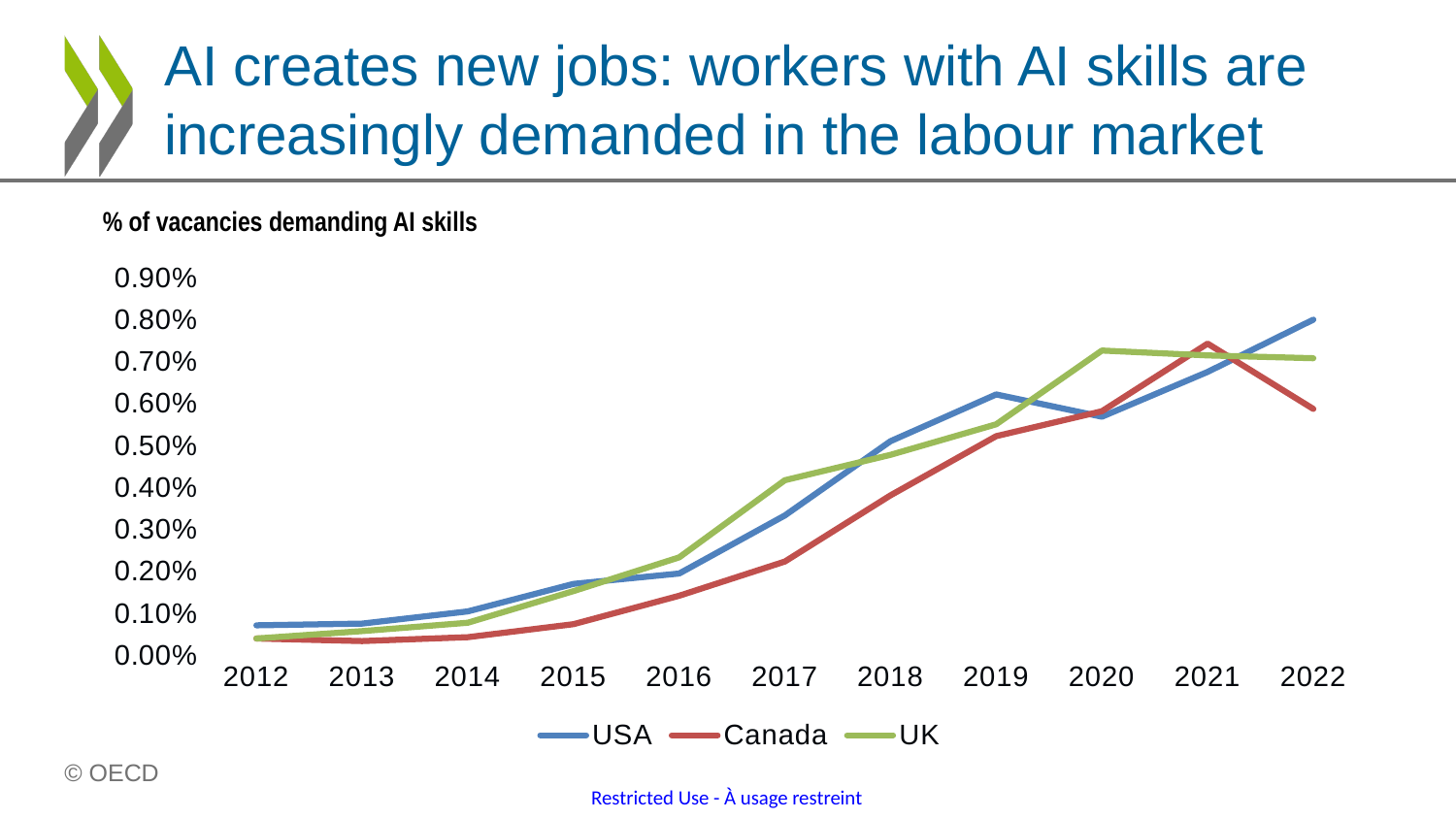
Is the value for USA in 2022 greater or less than 0.70%? greater Does the USA series generally rise or fall from 2012 to 2022? rise What is the title of the chart? % of vacancies demanding AI skills Which series has the lowest value in 2022? Canada Is the value for Canada in 2018 greater or less than 0.30%? greater Which series has the highest value in 2022? USA In 2021, which is larger: the value for Canada or the value for USA? Canada How many years are shown on the x axis? 11 What kind of chart is shown on the slide? line chart Which series is drawn in blue? USA Is the value for Canada in 2022 greater or less than 0.70%? less How many series does the legend list? 3